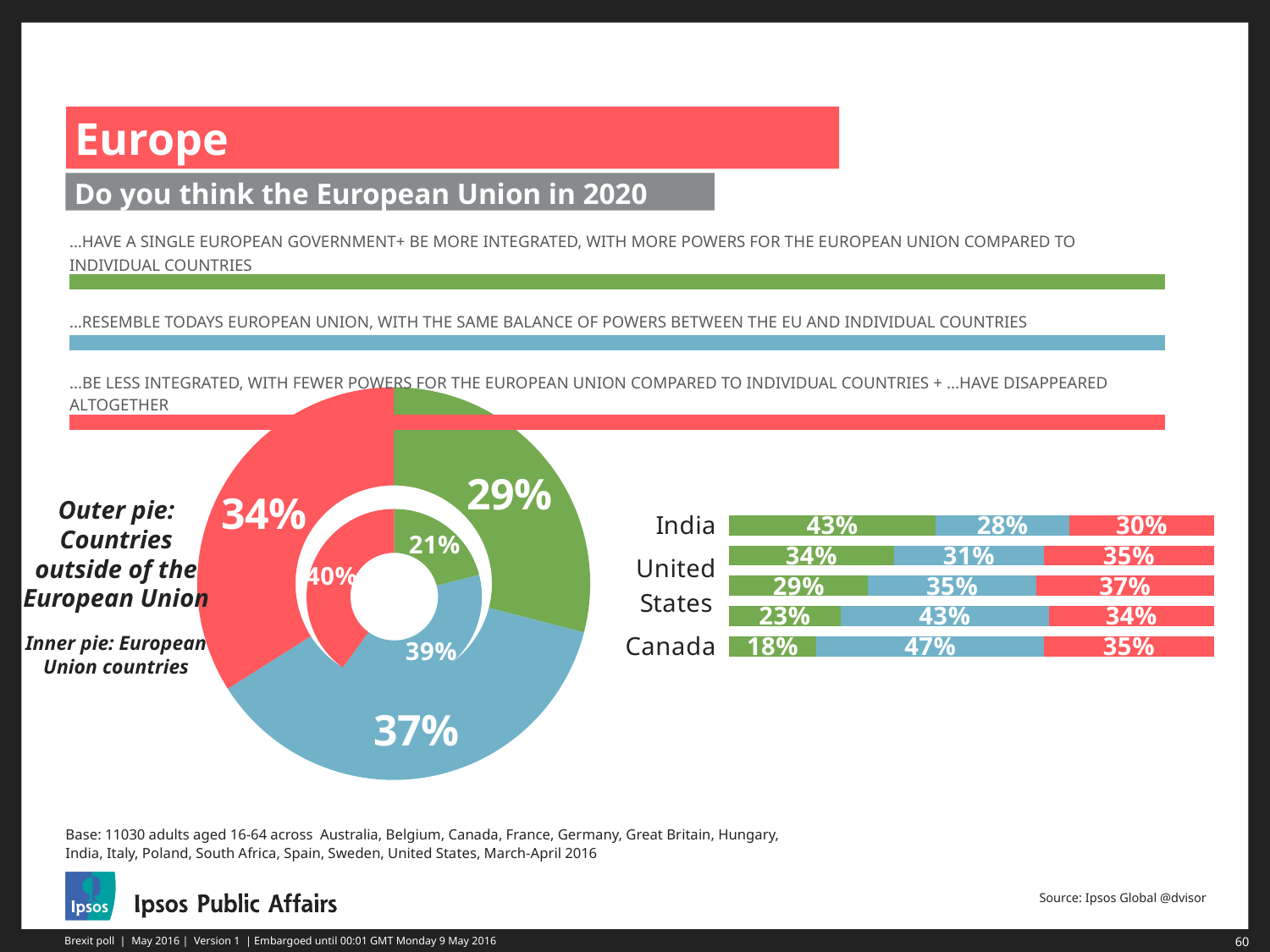
In the bar chart, which country has the larger percentage expecting the EU to resemble today's European Union, India or Canada? Canada In the bar chart, what percentage of respondents in Canada expect the EU to resemble today's European Union? 47% In the pie chart, what share of the inner pie (European Union countries) expects the EU to have a single European government or be more integrated? 21% In the pie chart, what share of the outer pie (countries outside the European Union) expects the EU in 2020 to resemble today's European Union? 37% In the pie chart, which response has the largest share of the outer pie (countries outside the European Union)? Resemble today's European Union (37%) In the bar chart, what percentage of respondents in India expect the EU to have a single European government or be more integrated? 43% In the pie chart, what share of the inner pie (European Union countries) expects the EU to be less integrated or to have disappeared altogether? 40% In the bar chart, what percentage of respondents in Canada expect the EU to have a single European government or be more integrated? 18% In the bar chart, what is the difference between India and Canada in the percentage expecting a single European government or more integration? 25 percentage points In the pie chart, what share of the outer pie (countries outside the European Union) expects the EU to be less integrated or to have disappeared altogether? 34% What kind of chart is shown on the left of the slide? Pie chart In the pie chart, which response has the smallest share of the inner pie (European Union countries)? Single European government / more integrated (21%)